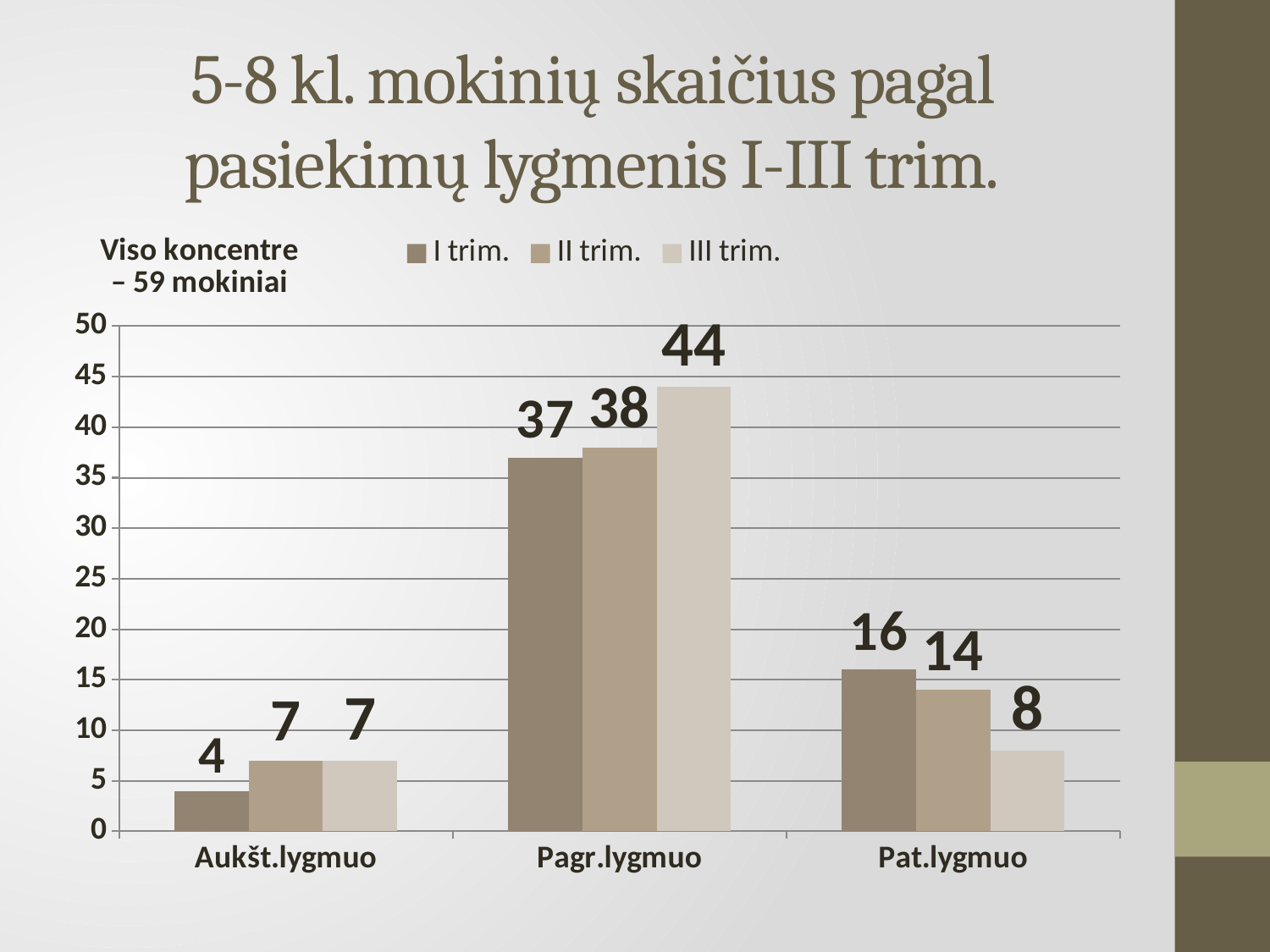
What is the difference between the I trim. and III trim. values in the Pat.lygmuo category? 8 What is the total number of students stated in the text box on the chart? 59 What is the value for I trim. in the Aukšt.lygmuo category? 4 Which is larger in the Pat.lygmuo category: the I trim. value or the II trim. value? I trim. What is the value for II trim. in the Pat.lygmuo category? 14 How many categories are shown on the x axis? 3 How many series does the legend list? 3 What kind of chart is shown on the slide? bar chart Which category has the highest value for I trim.? Pagr.lygmuo What is the difference between the III trim. and I trim. values in the Pagr.lygmuo category? 7 What is the value for III trim. in the Pagr.lygmuo category? 44 Which category has the lowest value for III trim.? Aukšt.lygmuo